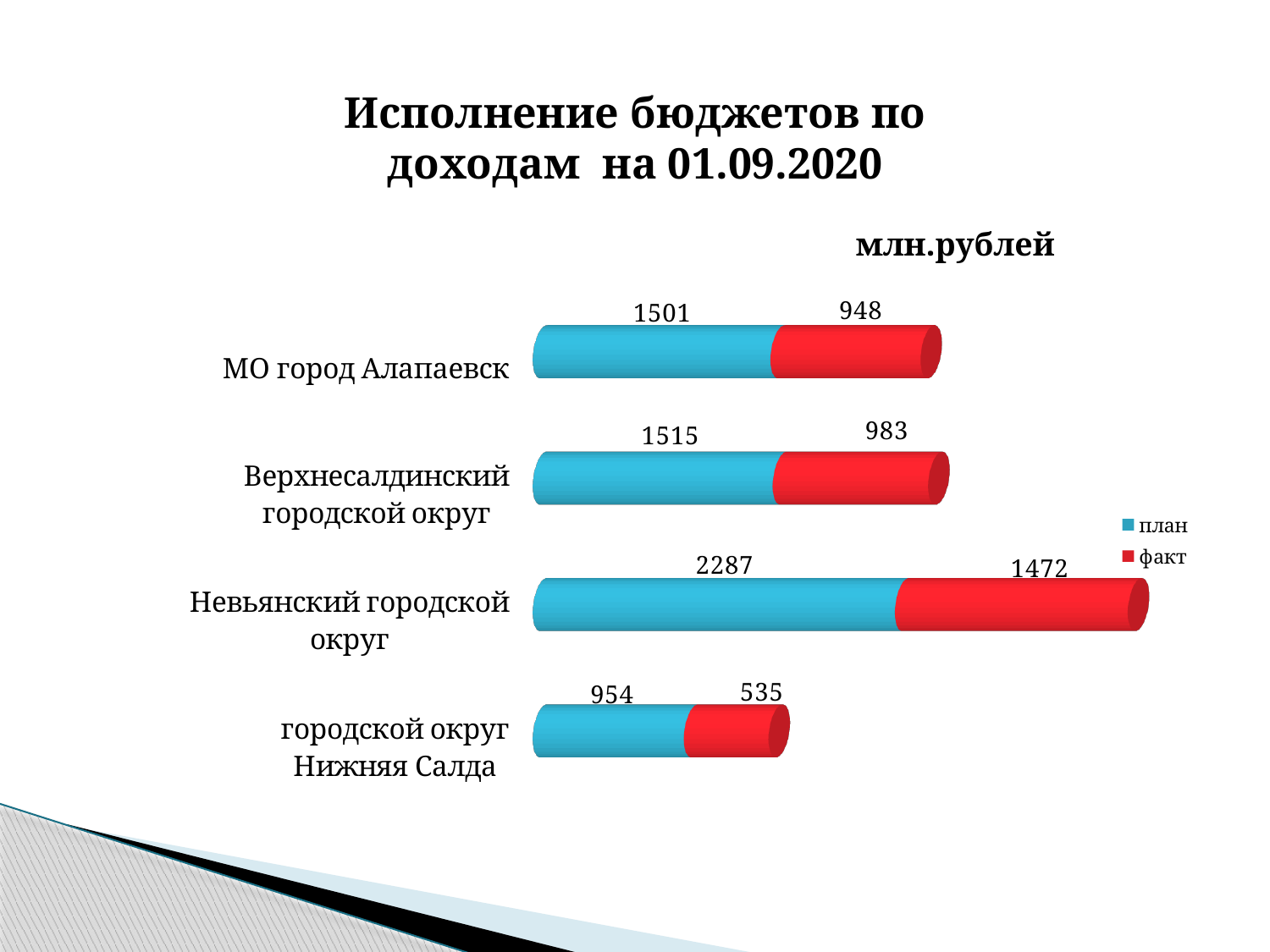
What unit is indicated for the values in the chart? млн.рублей Which category has the lowest факт value? городской округ Нижняя Салда What is the total of the stacked bar for городской округ Нижняя Салда? 1489 What is the план value for Невьянский городской округ? 2287 How many categories are shown in the chart? 4 What is the факт value for городской округ Нижняя Салда? 535 What is the факт value for МО город Алапаевск? 948 What is the difference between the план and факт values for Верхнесалдинский городской округ? 532 How many series does the legend list? 2 Which category has the highest план value? Невьянский городской округ What kind of chart is shown on the slide? Bar chart Which is larger: the факт value for Верхнесалдинский городской округ or the факт value for МО город Алапаевск? Верхнесалдинский городской округ